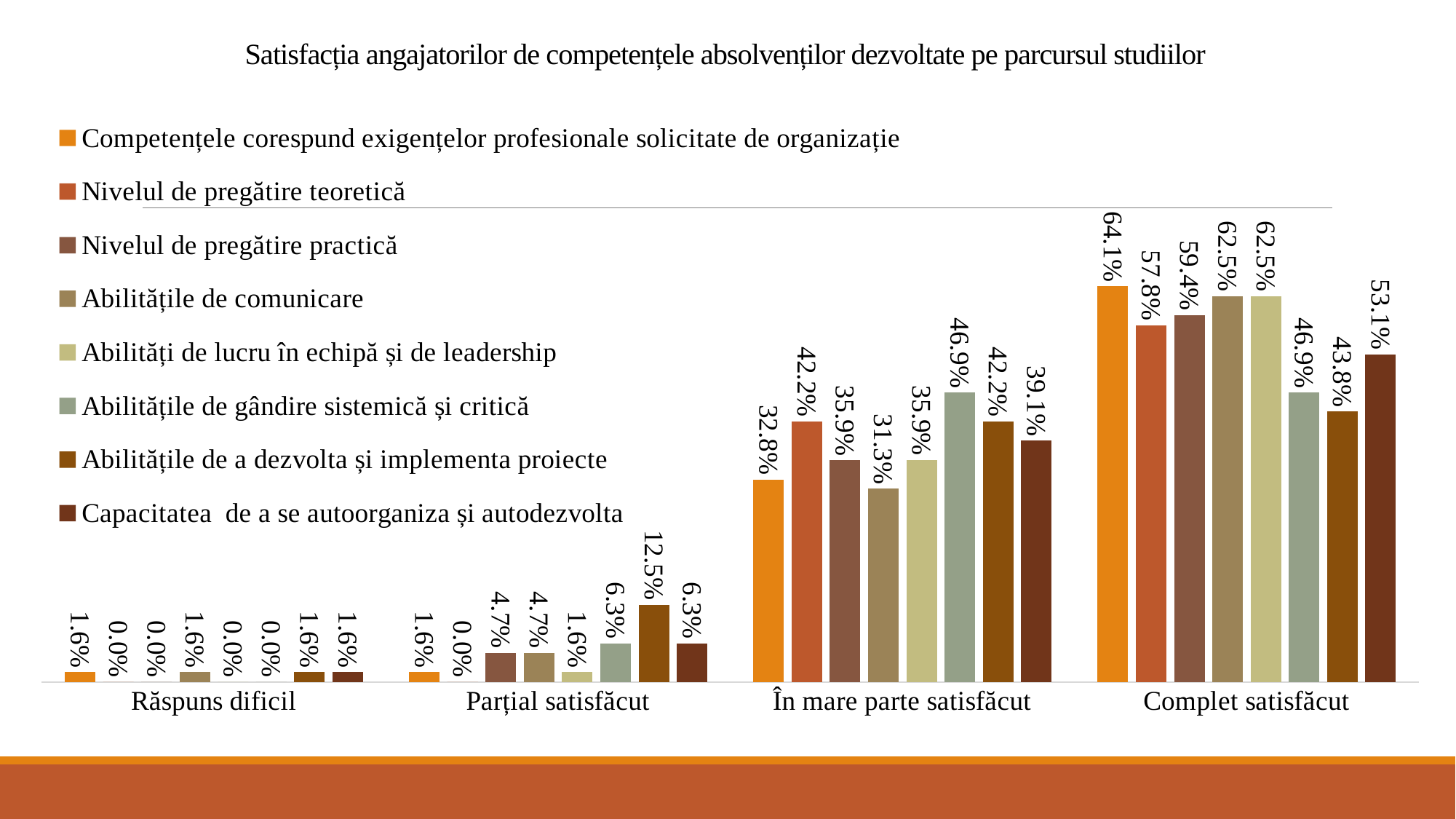
How many categories are shown on the x axis? 4 What kind of chart is shown on the slide? Bar chart Which series has the lowest value in the "În mare parte satisfăcut" category? Abilitățile de comunicare What is the difference between the "Complet satisfăcut" values for "Competențele corespund exigențelor profesionale solicitate de organizație" and "Abilitățile de a dezvolta și implementa proiecte"? 20.3% What is the title of the chart? Satisfacția angajatorilor de competențele absolvenților dezvoltate pe parcursul studiilor What is the value for "Abilitățile de a dezvolta și implementa proiecte" in the "Parțial satisfăcut" category? 12.5% What is the value for "Abilitățile de comunicare" in the "Răspuns dificil" category? 1.6% How many series does the legend list? 8 What is the value for "Abilitățile de gândire sistemică și critică" in the "În mare parte satisfăcut" category? 46.9% Which series has the highest value in the "Complet satisfăcut" category? Competențele corespund exigențelor profesionale solicitate de organizație What is the value for "Nivelul de pregătire teoretică" in the "Complet satisfăcut" category? 57.8% In the "În mare parte satisfăcut" category, which is larger: "Nivelul de pregătire teoretică" or "Competențele corespund exigențelor profesionale solicitate de organizație"? Nivelul de pregătire teoretică